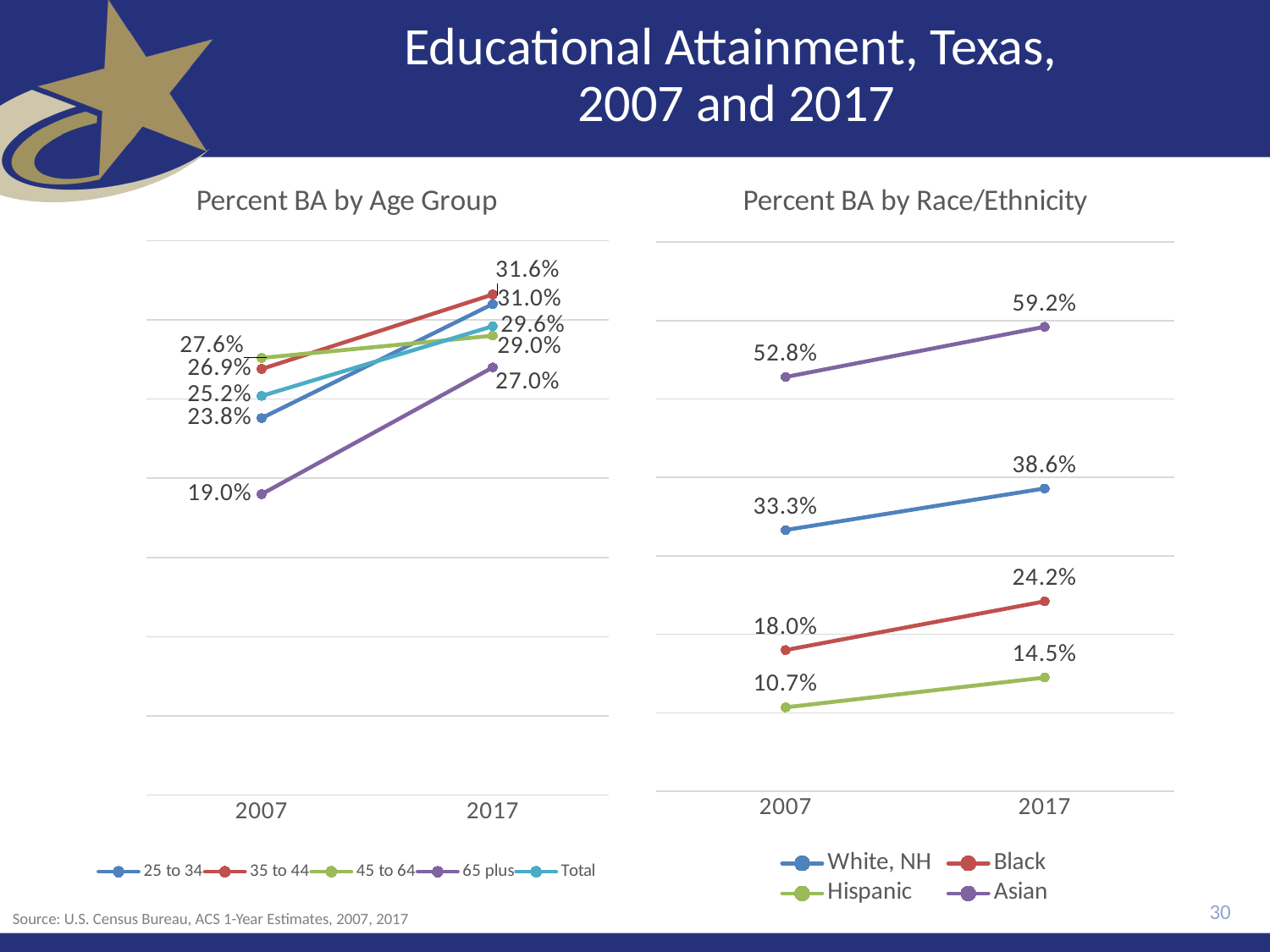
In the Percent BA by Race/Ethnicity chart, what is the value for Asian in 2017? 59.2% In the Percent BA by Race/Ethnicity chart, what is the value for Hispanic in 2007? 10.7% In the Percent BA by Age Group chart, does the value for 65 plus rise or fall from 2007 to 2017? Rise In the Percent BA by Race/Ethnicity chart, which is larger in 2017: the value for Black or the value for Hispanic? Black In the Percent BA by Race/Ethnicity chart, by how many percentage points did the White, NH value increase from 2007 to 2017? 5.3 percentage points How many series does the legend of the Percent BA by Race/Ethnicity chart list? 4 In the Percent BA by Race/Ethnicity chart, which group has the highest value in 2017? Asian In the Percent BA by Race/Ethnicity chart, which group has the lowest value in 2007? Hispanic How many series does the legend of the Percent BA by Age Group chart list? 5 In the Percent BA by Age Group chart, what is the value for 65 plus in 2007? 19.0% What kind of chart is the Percent BA by Age Group chart? Line chart In the Percent BA by Race/Ethnicity chart, by how many percentage points did the Black value increase from 2007 to 2017? 6.2 percentage points